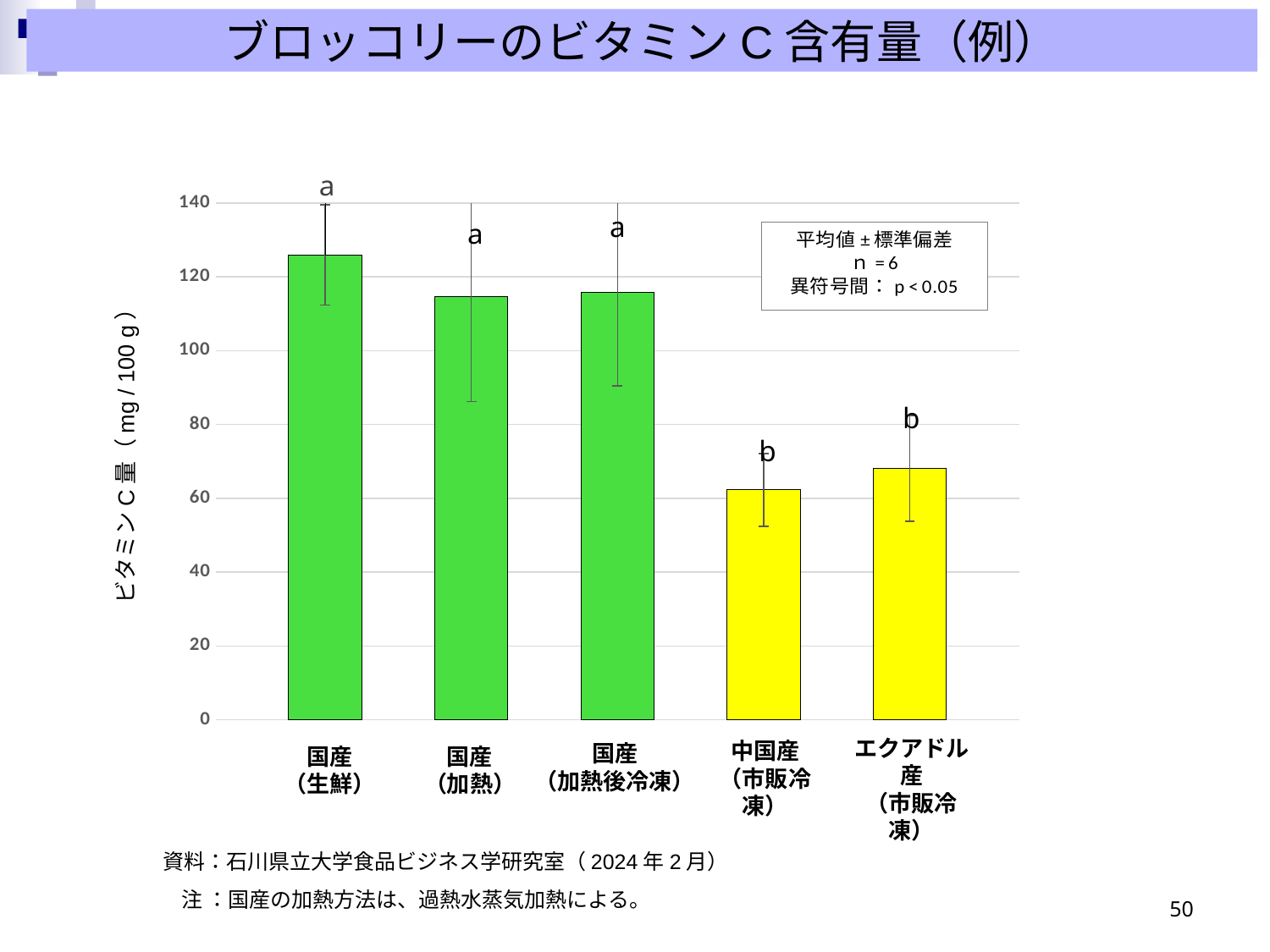
What kind of chart is shown on the slide? bar chart Which category has the lowest vitamin C content? 中国産（市販冷凍） How many categories are plotted on the x axis? 5 What sample size (n) is stated in the box on the chart? n = 6 What is the label of the y axis? ビタミンC量（mg / 100 g） Is the value for エクアドル産（市販冷凍） greater or less than 60? greater Is the value for 国産（生鮮） greater or less than 120? greater Is the value for 国産（加熱後冷凍） greater or less than 120? less Which is larger, the value for 国産（生鮮） or the value for 中国産（市販冷凍）? 国産（生鮮） Which category has the highest vitamin C content? 国産（生鮮）